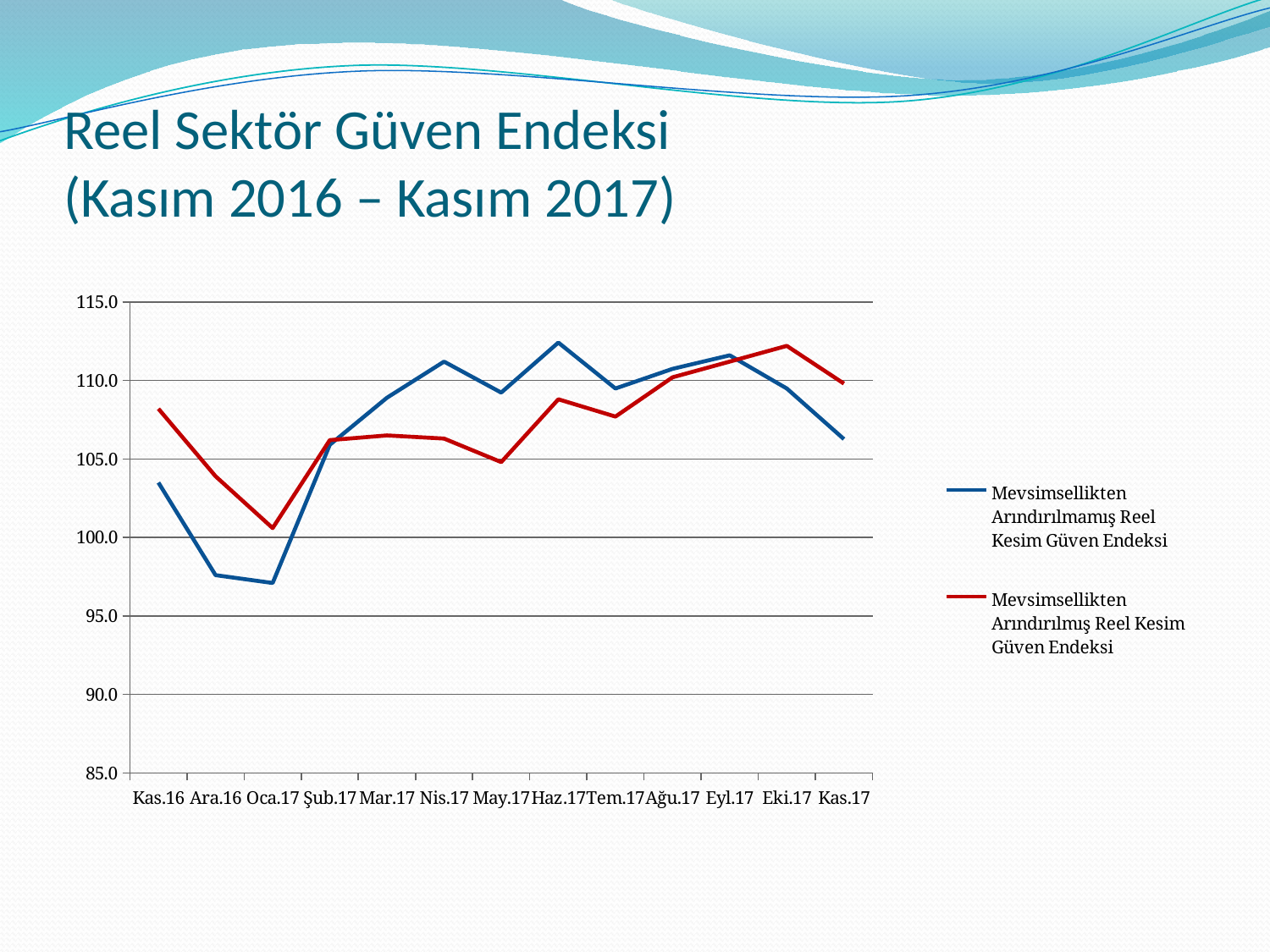
In Kas.16, which series has the higher value? Mevsimsellikten Arındırılmış Reel Kesim Güven Endeksi Which month has the lowest value for the Mevsimsellikten Arındırılmış Reel Kesim Güven Endeksi series? Oca.17 Which month has the highest value for the Mevsimsellikten Arındırılmamış Reel Kesim Güven Endeksi series? Haz.17 Is the value of the Mevsimsellikten Arındırılmamış Reel Kesim Güven Endeksi in Haz.17 greater or less than 110.0? greater In Haz.17, which series has the higher value? Mevsimsellikten Arındırılmamış Reel Kesim Güven Endeksi What kind of chart is shown on the slide? line chart How many months are shown along the x axis? 13 How many series does the legend list? 2 Is the value of the Mevsimsellikten Arındırılmamış Reel Kesim Güven Endeksi in Oca.17 greater or less than 100.0? less Do both series rise or fall from Eki.17 to Kas.17? fall Is the value of the Mevsimsellikten Arındırılmış Reel Kesim Güven Endeksi in Kas.16 greater or less than 105.0? greater Which month has the highest value for the Mevsimsellikten Arındırılmış Reel Kesim Güven Endeksi series? Eki.17